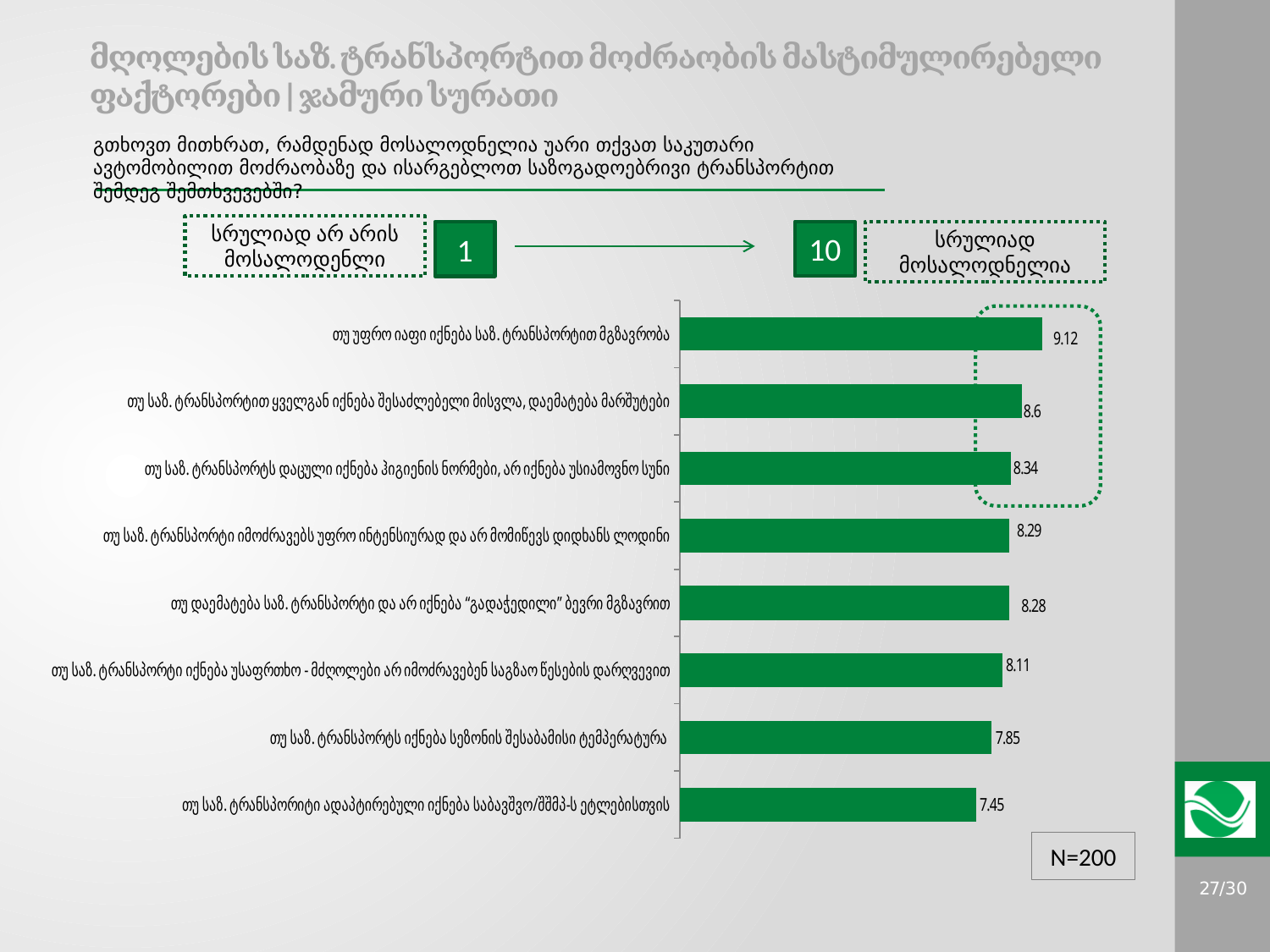
What is the range of the rating scale shown above the chart? 1 to 10 What is the difference between the highest value (9.12) and the lowest value (7.45)? 1.67 What type of chart is shown on the slide? bar chart Which is larger: the value for "თუ საზ. ტრანსპორტით ყველგან იქნება შესაძლებელი მისვლა, დაემატება მარშრუტები" or the value for "თუ საზ. ტრანსპორტს ექნება სეზონის შესაბამისი ტემპერატურა"? თუ საზ. ტრანსპორტით ყველგან იქნება შესაძლებელი მისვლა, დაემატება მარშრუტები How many categories (bars) does the chart show? 8 What is the value for "თუ უფრო იაფი იქნება საზ. ტრანსპორტით მგზავრობა"? 9.12 Which category has the highest value? თუ უფრო იაფი იქნება საზ. ტრანსპორტით მგზავრობა Which category has the lowest value? თუ საზ. ტრანსპორიტი ადაპტირებული იქნება საბავშვო/შშმპ-ს ეტლებისთვის What is the difference between the values 8.6 and 8.34 shown for the second and third bars? 0.26 What is the value for "თუ საზ. ტრანსპორტს ექნება სეზონის შესაბამისი ტემპერატურა"? 7.85 What sample size (N) is shown on the slide? N=200 What is the value for "თუ საზ. ტრანსპორტი იქნება უსაფრთხო - მძღოლები არ იმოძრავებენ საგზაო წესების დარღვევით"? 8.11